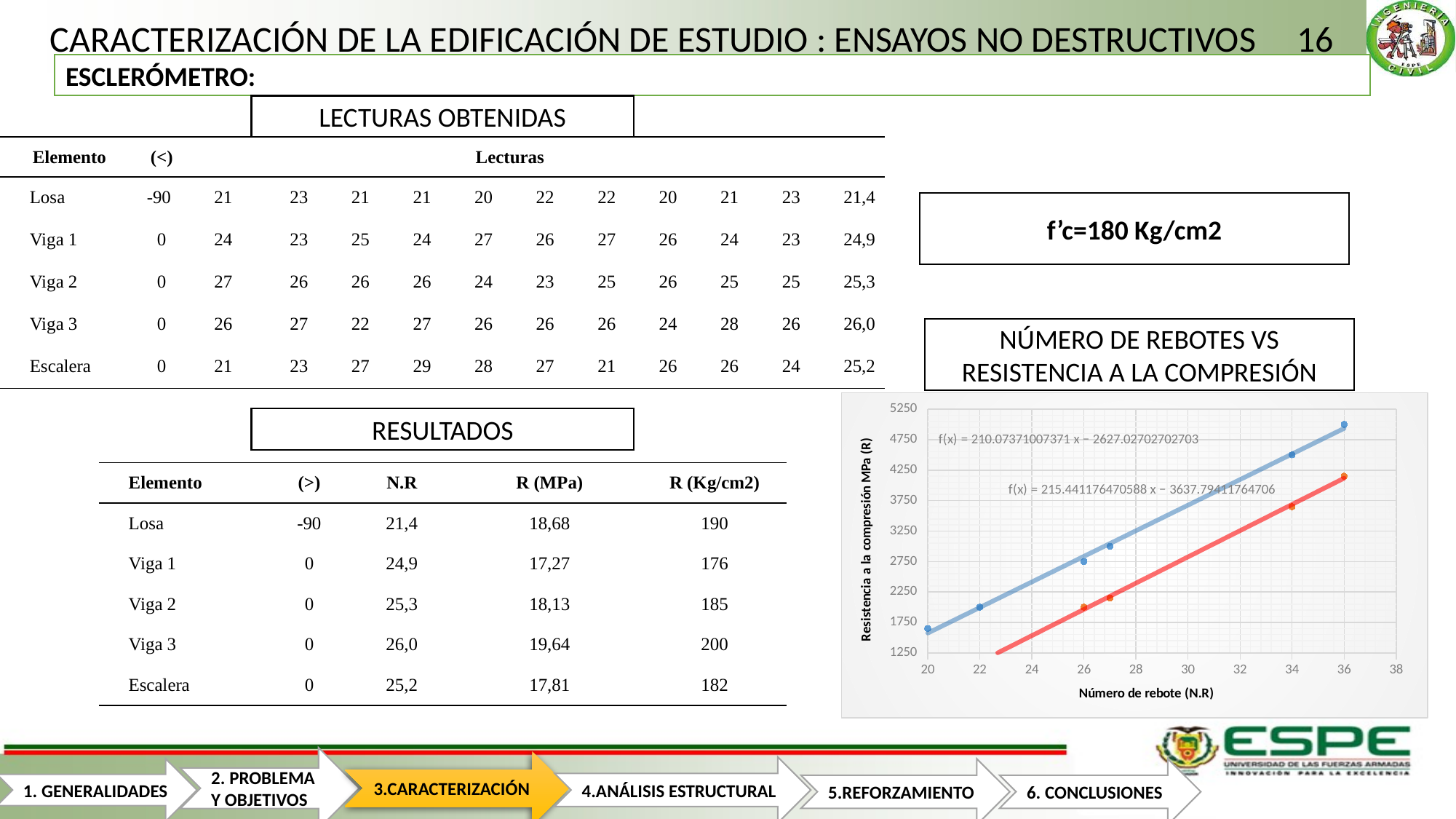
What is the trendline equation printed at the top of the chart? f(x) = 210.07371007371 x − 2627.02702702703 What kind of chart is shown under the title 'NÚMERO DE REBOTES VS RESISTENCIA A LA COMPRESIÓN'? scatter chart In the chart, do the plotted values rise or fall as the number of rebounds (N.R) increases along the x axis? rise Is the value of the red series at N.R = 26 greater or less than 2250? less How many red data points are plotted in the chart? 4 What is the title of the x axis of the chart? Número de rebote (N.R) At N.R = 34, which series has the higher value, the blue one or the red one? blue How many blue data points are plotted in the chart? 6 Is the value of the blue series at N.R = 36 greater or less than 4750? greater Is the value of the blue series at N.R = 20 greater or less than 1750? less